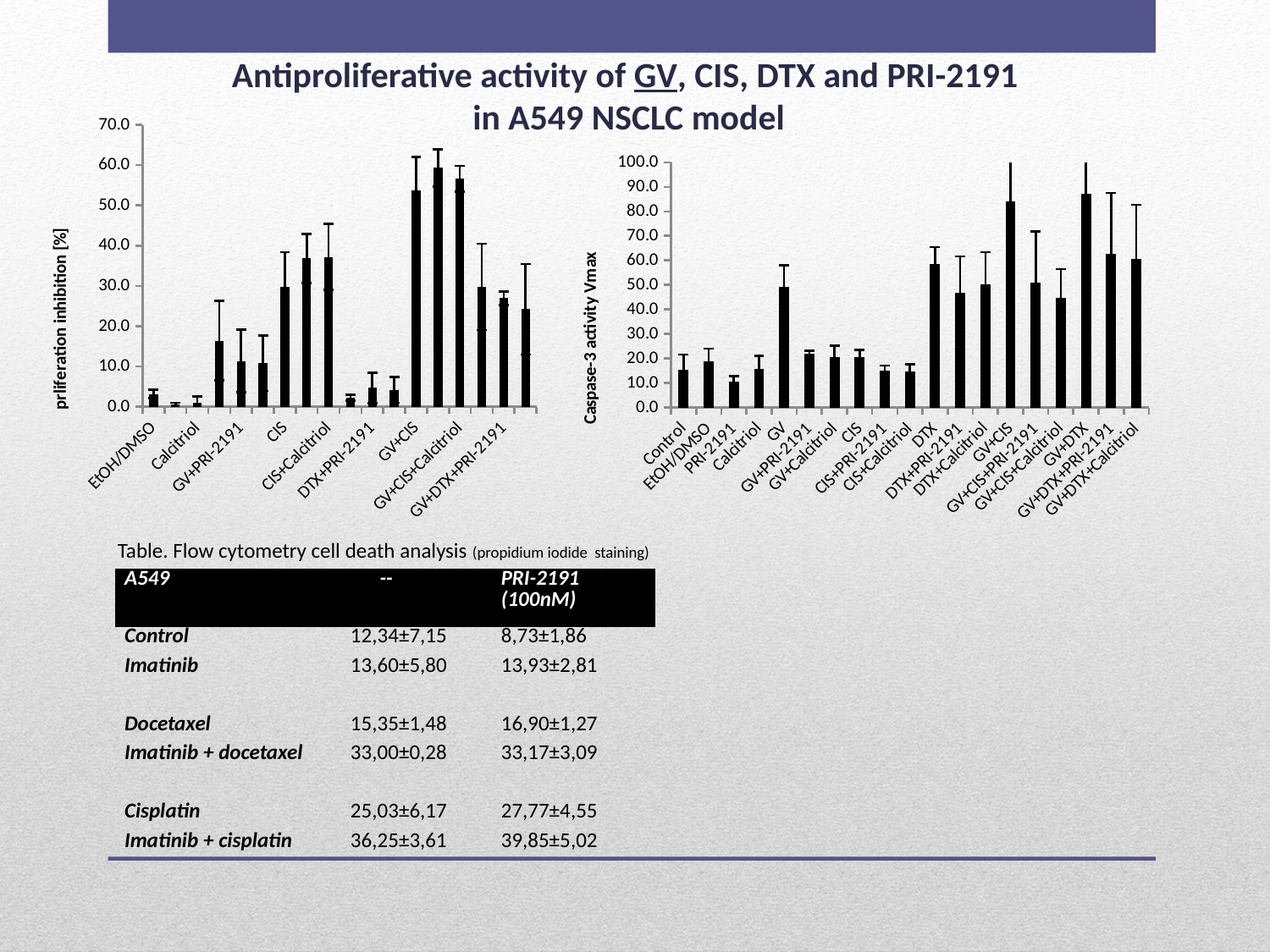
In the left chart (proliferation inhibition), is the value for GV+CIS+Calcitriol greater or less than 50? greater In the right chart (Caspase-3 activity Vmax), is the value for GV+DTX greater or less than 80? greater What is the y-axis title of the right chart? Caspase-3 activity Vmax In the right chart (Caspase-3 activity Vmax), which is larger, the value for GV or the value for CIS? GV What kind of chart is the right chart (Caspase-3 activity Vmax)? bar chart In the left chart (proliferation inhibition), is the value for CIS+Calcitriol greater or less than 30? greater In the right chart (Caspase-3 activity Vmax), how many categories are shown on the x axis? 19 In the left chart (proliferation inhibition), which is larger, the value for GV+CIS or the value for CIS? GV+CIS What kind of chart is the left chart (proliferation inhibition)? bar chart